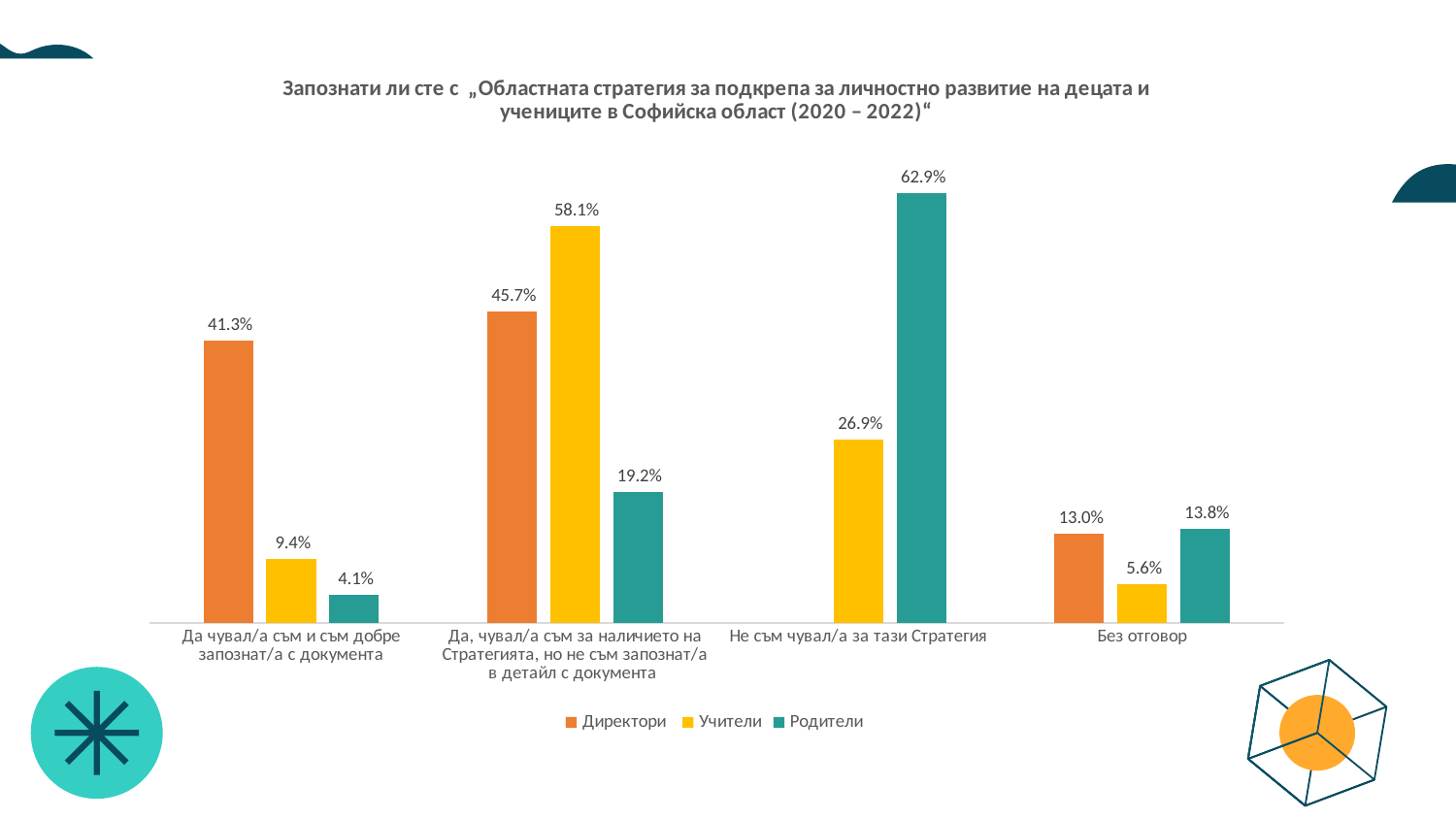
Which series has the lowest value in the category "Да чувал/а съм и съм добре запознат/а с документа"? Родители What is the difference between the Учители and Директори values in the category "Да, чувал/а съм за наличието на Стратегията, но не съм запознат/а в детайл с документа"? 12.4% What is the value for Директори in the category "Да чувал/а съм и съм добре запознат/а с документа"? 41.3% What is the value for Учители in the category "Без отговор"? 5.6% What is the value for Родители in the category "Не съм чувал/а за тази Стратегия"? 62.9% What type of chart is shown on the slide? bar chart Which is larger: the Родители value for "Без отговор" or the Директори value for "Без отговор"? Родители Which colour represents the Учители series in the legend? yellow How many series does the legend list? 3 What is the difference between the Родители and Учители values in the category "Не съм чувал/а за тази Стратегия"? 36.0% Which series has the highest value in the category "Да, чувал/а съм за наличието на Стратегията, но не съм запознат/а в детайл с документа"? Учители How many categories are shown on the x axis? 4